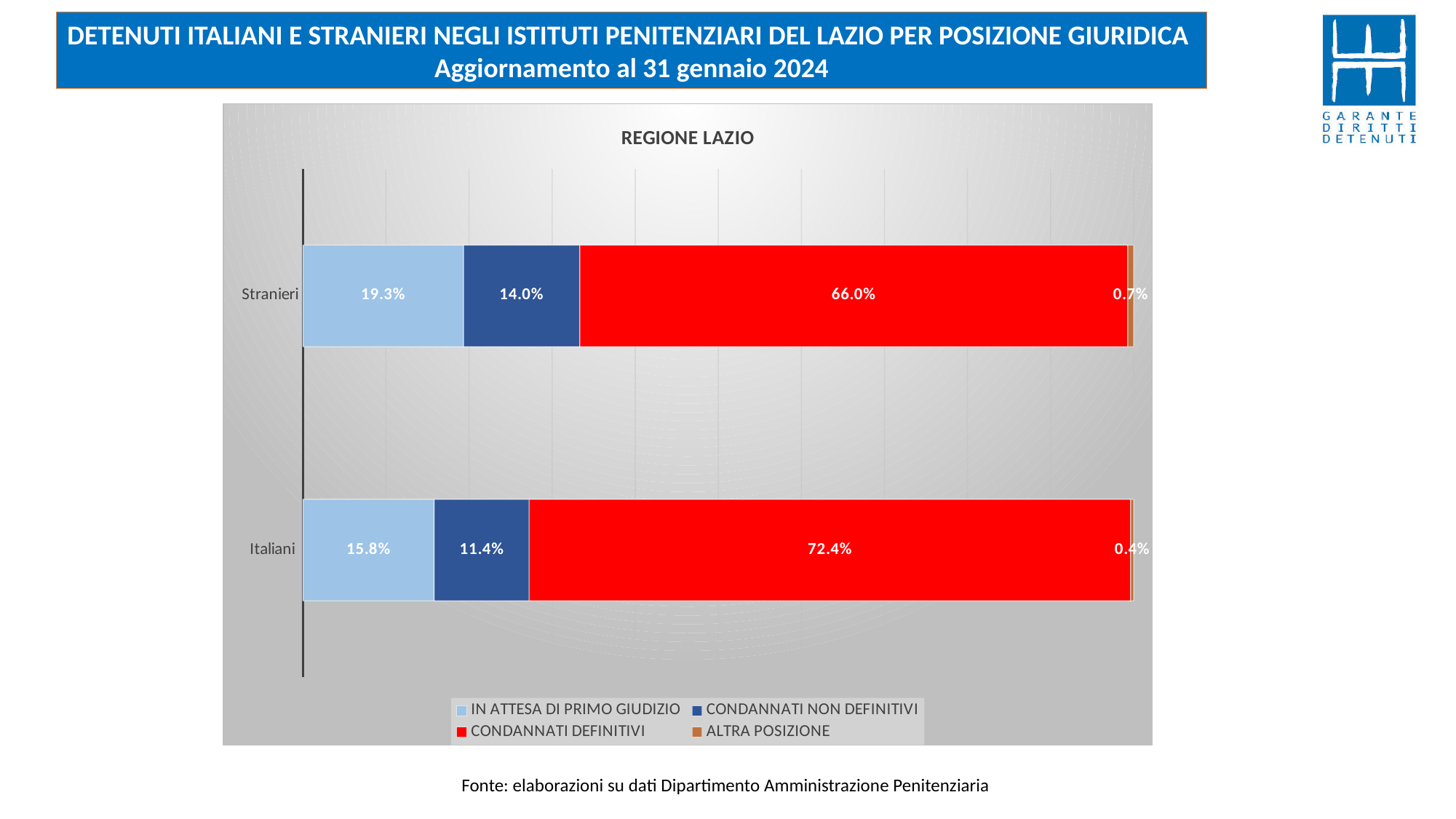
Which category has the higher value for CONDANNATI DEFINITIVI, Stranieri or Italiani? Italiani What is the difference between the CONDANNATI NON DEFINITIVI values for Stranieri and Italiani? 2.6% What is the value for IN ATTESA DI PRIMO GIUDIZIO in the Italiani bar? 15.8% What is the value for CONDANNATI DEFINITIVI in the Stranieri bar? 66.0% How many series does the legend list? 4 Which category has the higher value for IN ATTESA DI PRIMO GIUDIZIO, Stranieri or Italiani? Stranieri Which series has the smallest value in the Stranieri bar? ALTRA POSIZIONE What is the value for CONDANNATI NON DEFINITIVI in the Stranieri bar? 14.0% What is the difference between the CONDANNATI DEFINITIVI values for Italiani and Stranieri? 6.4% What is the value for ALTRA POSIZIONE in the Italiani bar? 0.4% What type of chart is shown on the slide? Stacked bar chart Which series has the largest value in the Italiani bar? CONDANNATI DEFINITIVI